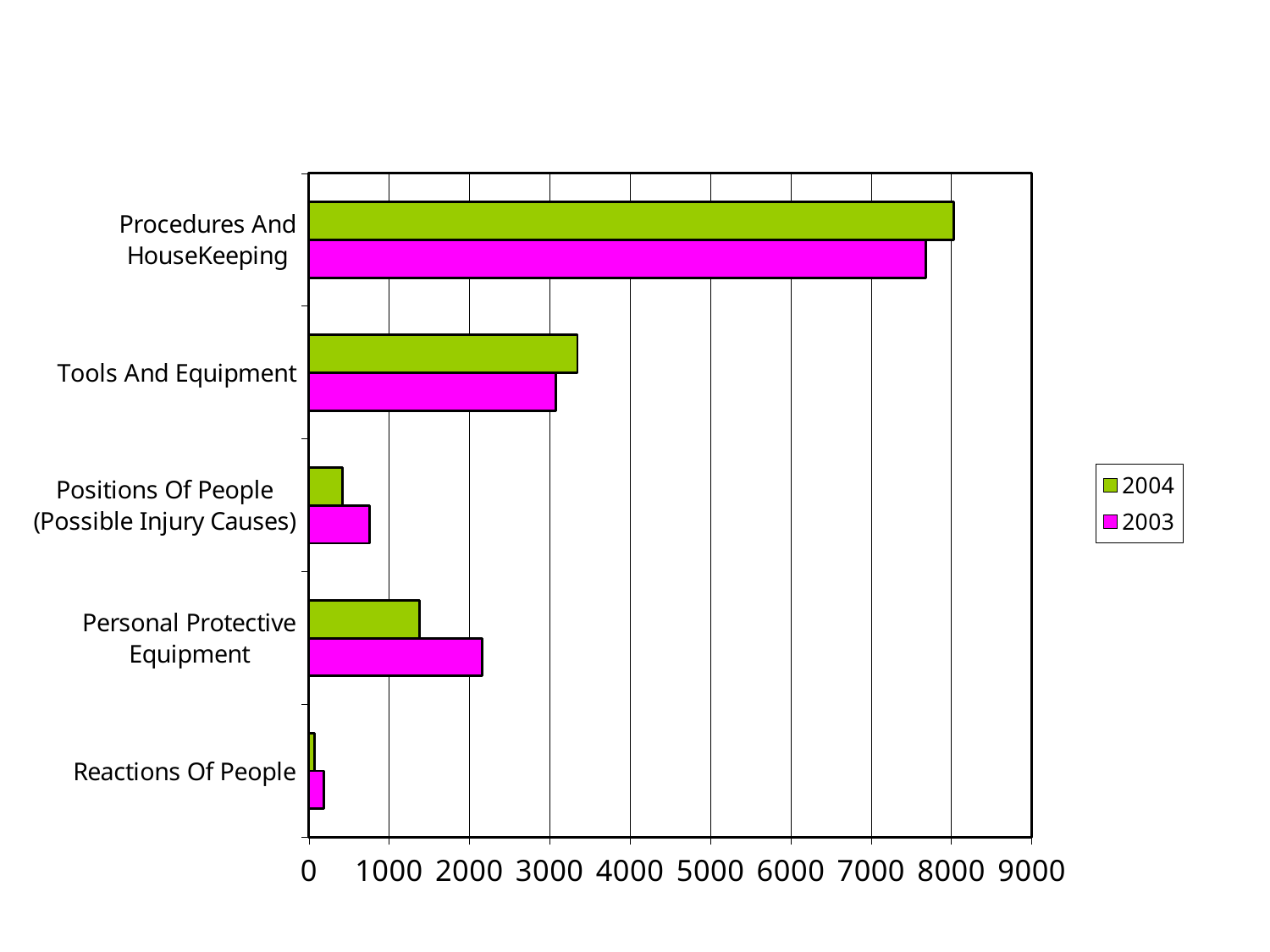
How many series does the legend list? 2 Is the 2004 value for Procedures And HouseKeeping greater or less than 7000? greater For Personal Protective Equipment, which year has the larger value, 2003 or 2004? 2003 Which colour represents the 2003 series in the legend? magenta How many categories are shown on the chart? 5 For Procedures And HouseKeeping, which year has the larger value, 2003 or 2004? 2004 Which category has the highest value for 2004? Procedures And HouseKeeping What kind of chart is shown on the slide? bar chart Is the 2004 value for Tools And Equipment greater or less than 3000? greater Which category has the lowest value for 2003? Reactions Of People Is the 2003 value for Personal Protective Equipment greater or less than 2000? greater